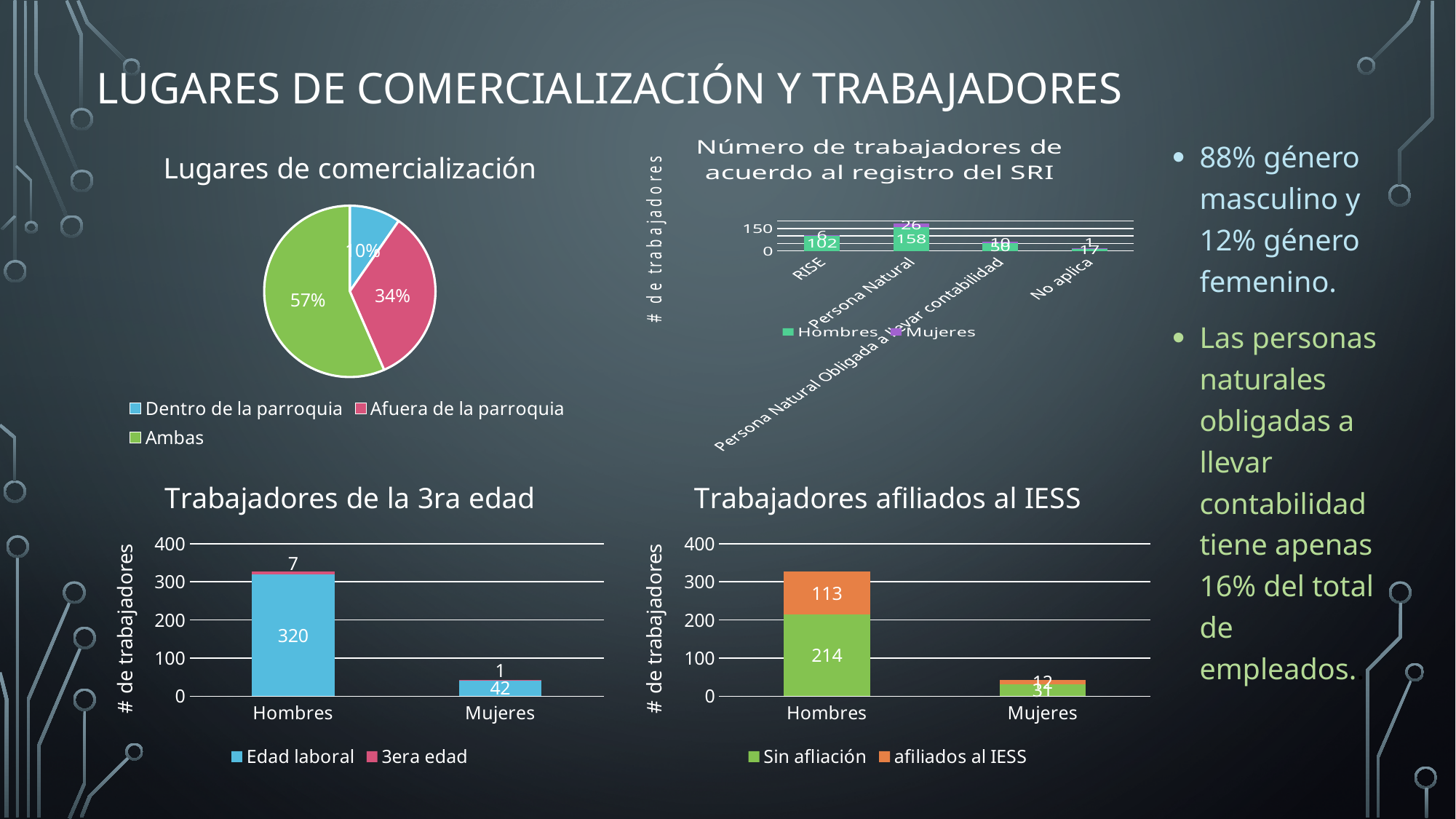
In the 'Trabajadores de la 3ra edad' chart, what is the total of the stacked bar for Mujeres? 43 In the 'Lugares de comercialización' pie chart, which category has the smallest share? Dentro de la parroquia In the 'Trabajadores de la 3ra edad' chart, what is the 'Edad laboral' value for Hombres? 320 In the 'Trabajadores afiliados al IESS' chart, what is the 'afiliados al IESS' value for Hombres? 113 What type of chart is 'Lugares de comercialización'? Pie chart In the 'Trabajadores afiliados al IESS' chart, what is the total of the stacked bar for Hombres? 327 In the 'Número de trabajadores de acuerdo al registro del SRI' chart, how many categories are shown on the x axis? 4 In the 'Trabajadores de la 3ra edad' chart, is the total for Hombres greater or less than 300? greater In the 'Lugares de comercialización' pie chart, what percentage is shown for 'Ambas'? 57% In the 'Lugares de comercialización' pie chart, what is the difference between the 'Afuera de la parroquia' and 'Dentro de la parroquia' shares? 24% How many series does the legend of the 'Trabajadores afiliados al IESS' chart list? 2 In the 'Número de trabajadores de acuerdo al registro del SRI' chart, what is the value for Hombres in the 'Persona Natural' category? 158